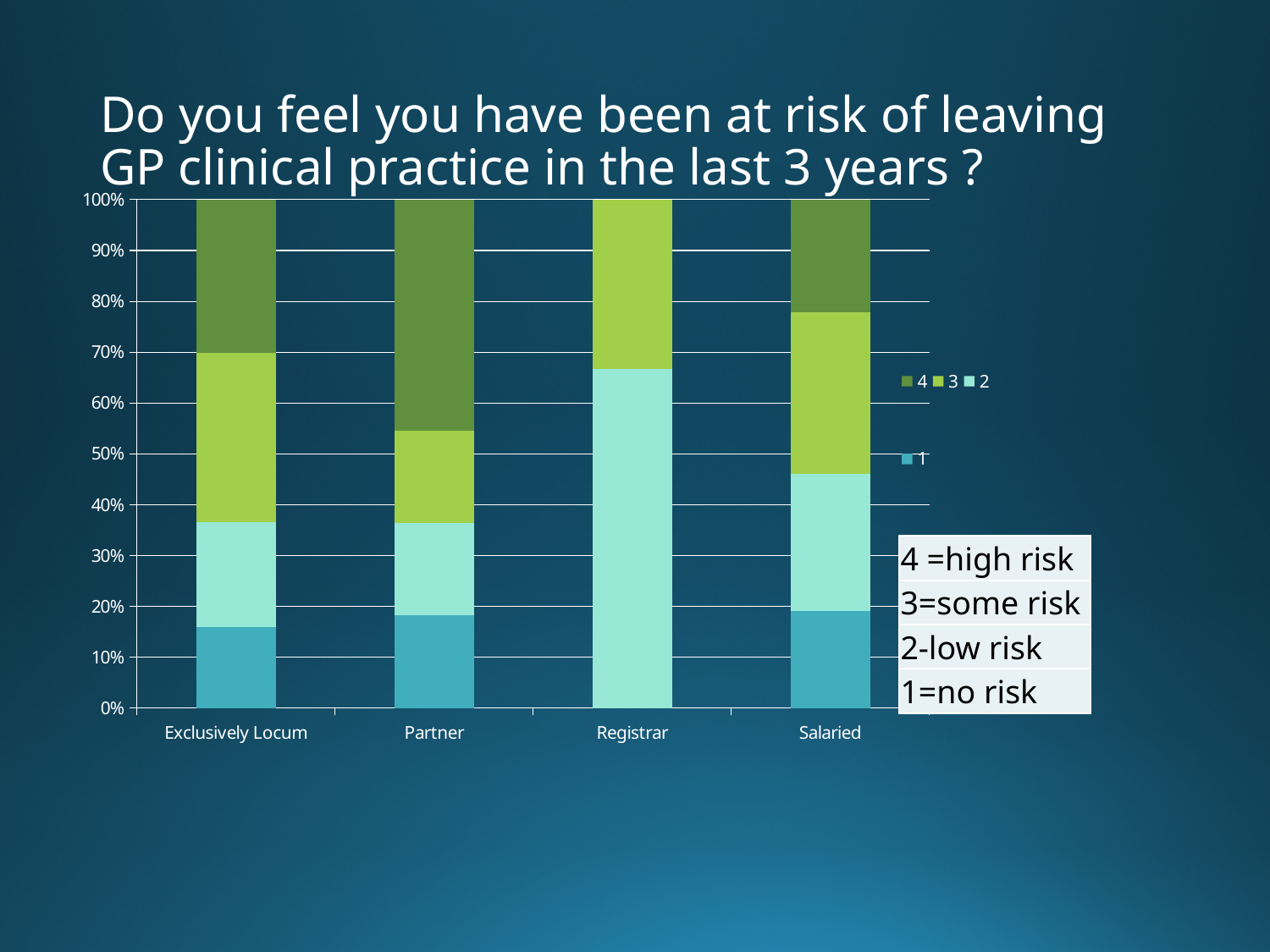
Is the share of series 1 (no risk) for Exclusively Locum greater or less than 20%? less Which category has the largest share of series 4 (high risk)? Partner Which category has the largest share of series 2 (low risk)? Registrar Is the share of series 2 (low risk) for Registrar greater or less than 60%? greater Is the share of series 4 (high risk) for Salaried greater or less than 30%? less According to the key on the slide, what does a rating of 4 mean? high risk Is the share of series 3 (some risk) larger for Exclusively Locum or for Partner? Exclusively Locum How many series does the chart's legend list? 4 How many categories are shown along the x axis of the chart? 4 What kind of chart is shown on the slide? Stacked bar chart What is the title of the chart? Do you feel you have been at risk of leaving GP clinical practice in the last 3 years ?